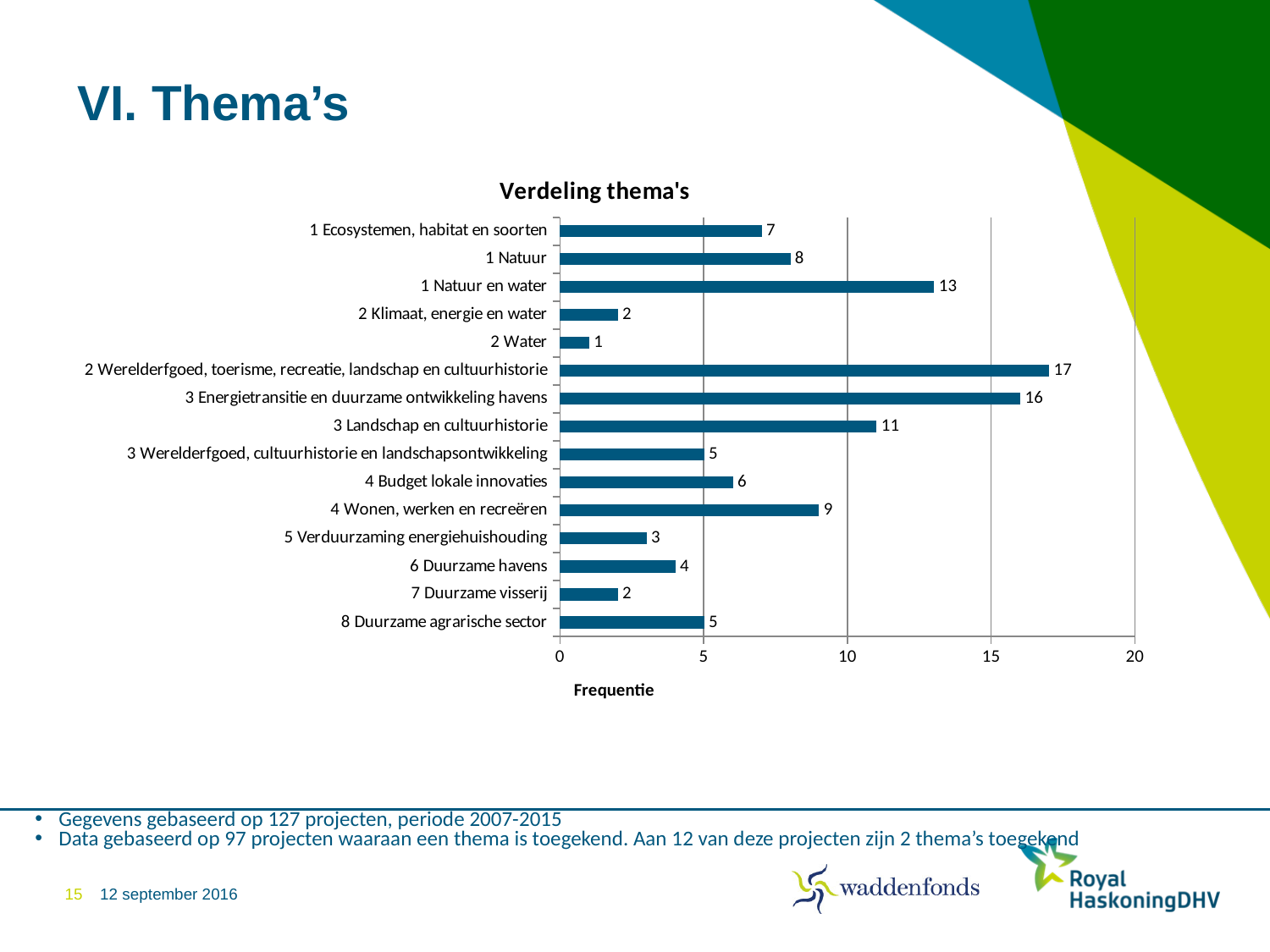
How many categories are shown in the chart? 15 What is the value for '1 Natuur en water'? 13 Which category has the highest value? 2 Werelderfgoed, toerisme, recreatie, landschap en cultuurhistorie What is the label of the horizontal axis? Frequentie What is the value for '4 Wonen, werken en recreëren'? 9 What kind of chart is this? bar chart Which is larger: '1 Natuur' or '4 Budget lokale innovaties'? 1 Natuur What is the value for '6 Duurzame havens'? 4 What is the difference between '3 Energietransitie en duurzame ontwikkeling havens' and '3 Landschap en cultuurhistorie'? 5 Is the value for '3 Landschap en cultuurhistorie' greater or less than 10? greater What is the title of the chart? Verdeling thema's Which category has the lowest value? 2 Water